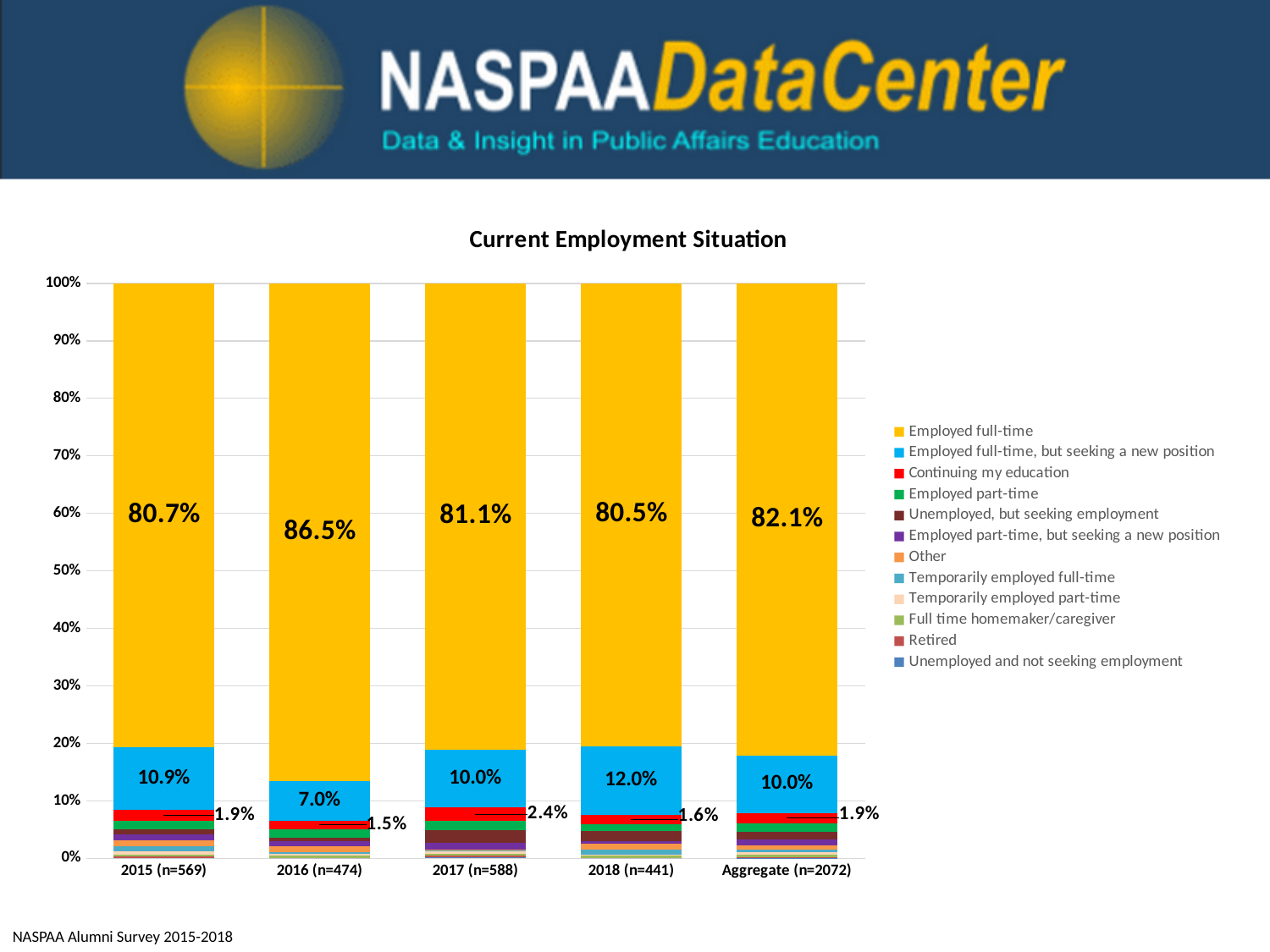
Which is larger: the Employed full-time value for 2017 (n=588) or for 2018 (n=441)? 2017 (n=588) Which category has the lowest 'Employed full-time, but seeking a new position' value? 2016 (n=474) Which year has the highest Employed full-time share? 2016 (n=474) What type of chart is shown on the slide? Stacked bar chart What is the Employed full-time value for the Aggregate (n=2072) bar? 82.1% Which legend entry is shown in yellow? Employed full-time How many series does the chart legend list? 12 What is the 'Employed full-time, but seeking a new position' value for 2018 (n=441)? 12.0% What is the difference between the Employed full-time values for 2016 (n=474) and 2015 (n=569)? 5.8% How many bars (categories) are shown on the x axis? 5 What is the title of the chart? Current Employment Situation What is the Employed full-time value for 2016 (n=474)? 86.5%